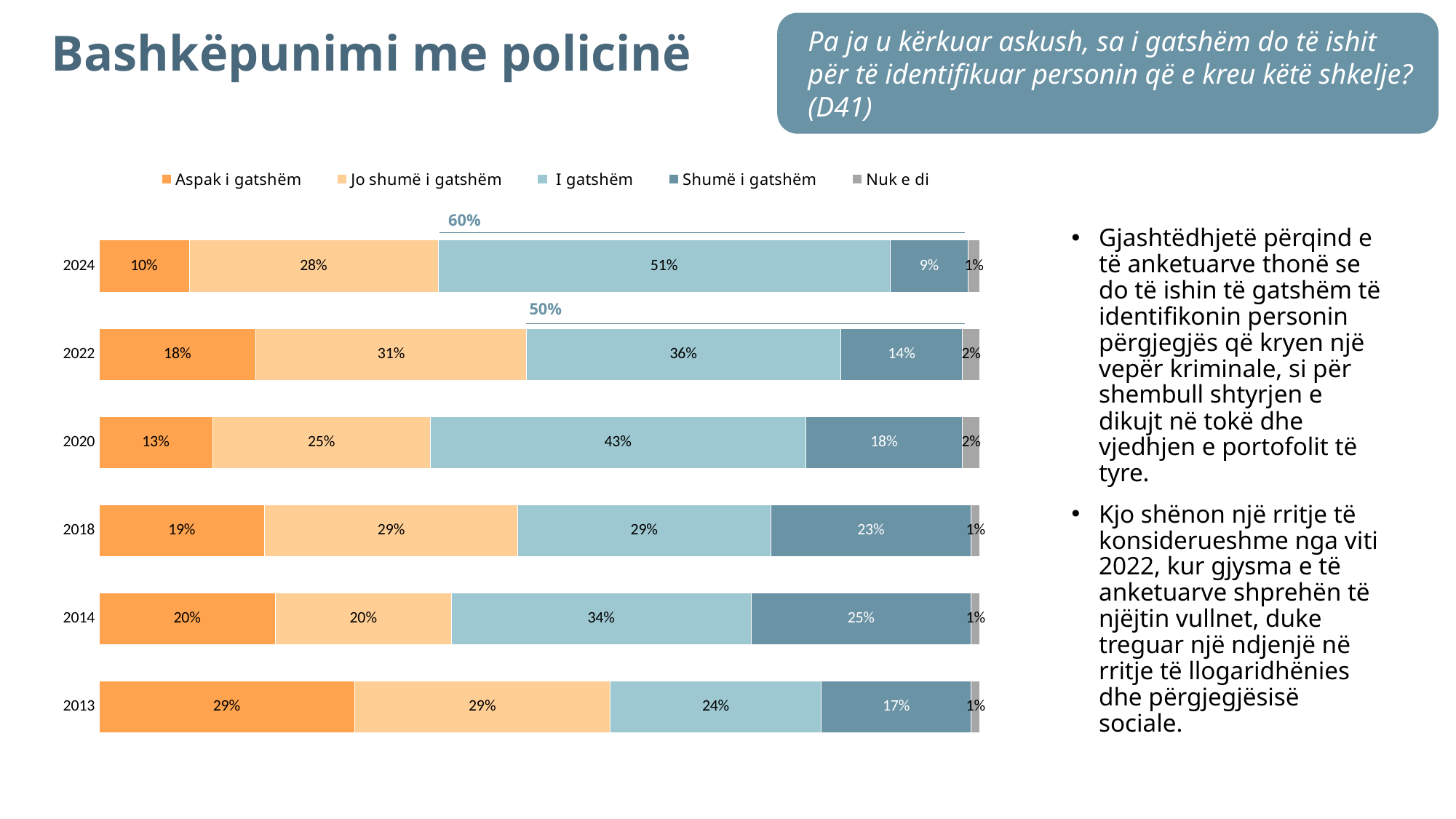
What percentage of respondents in 2018 answered "Shumë i gatshëm"? 23% Which year has a larger "Shumë i gatshëm" share, 2014 or 2018? 2014 How many years are shown in the chart? 6 What combined percentage is annotated above the 2022 bar? 50% Which year has the lowest share of "Shumë i gatshëm" responses? 2024 By how many percentage points did the "I gatshëm" share increase from 2022 to 2024? 15 percentage points Which year has the lowest share of "Aspak i gatshëm" responses? 2024 What type of chart is shown on the slide? Stacked bar chart Which year has the highest share of "I gatshëm" responses? 2024 How many response categories does the legend list? 5 What percentage of respondents in 2024 answered "I gatshëm"? 51% What percentage of respondents in 2013 answered "Aspak i gatshëm"? 29%